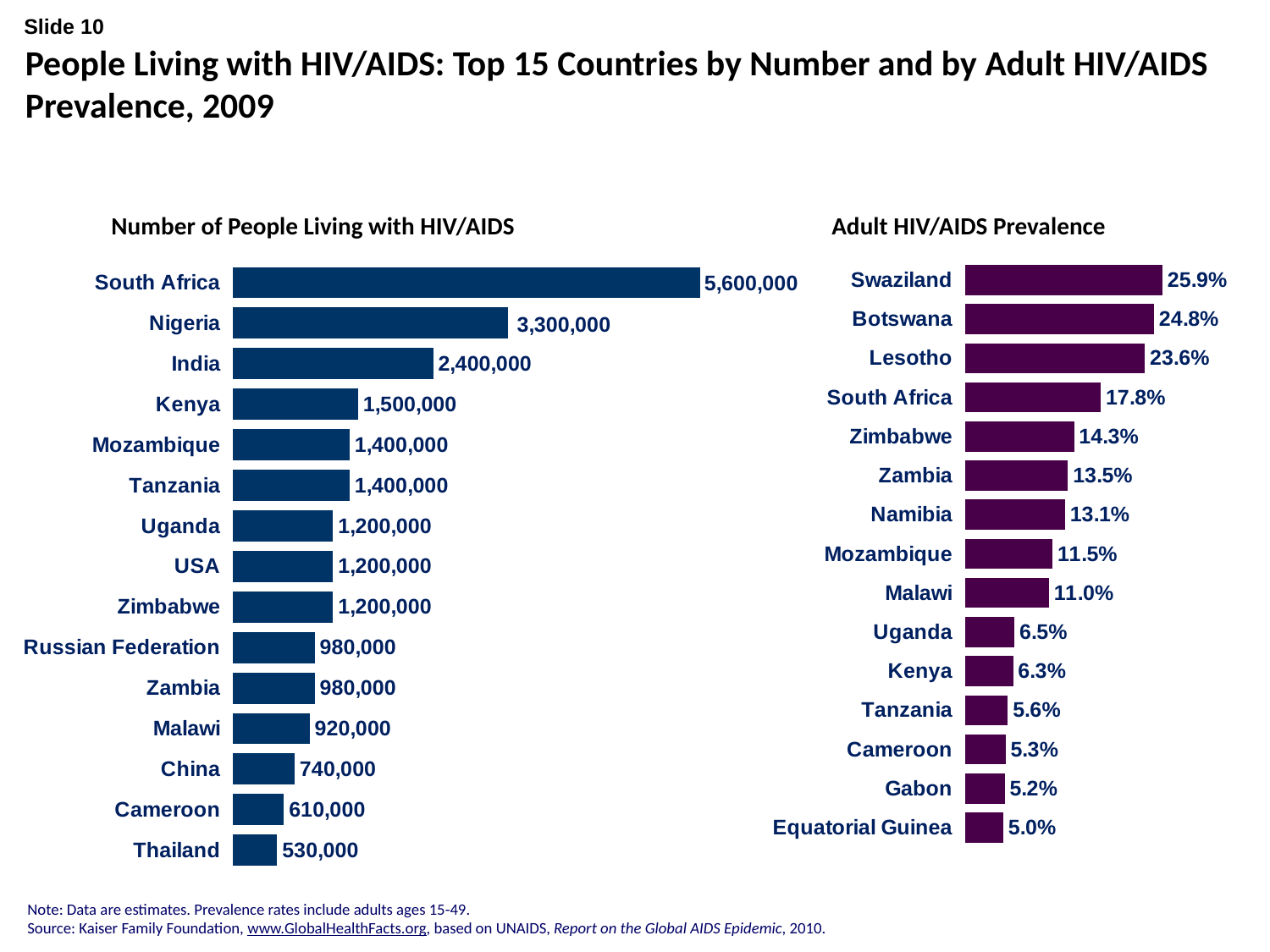
In the 'Adult HIV/AIDS Prevalence' chart, which is larger, the value for Namibia or the value for Malawi? Namibia In the 'Number of People Living with HIV/AIDS' chart, which country has the highest value? South Africa In the 'Number of People Living with HIV/AIDS' chart, what is the value for China? 740,000 In the 'Number of People Living with HIV/AIDS' chart, what is the difference between South Africa and India? 3,200,000 In the 'Adult HIV/AIDS Prevalence' chart, what is the value for Zimbabwe? 14.3% In the 'Adult HIV/AIDS Prevalence' chart, what is the difference between Swaziland and Botswana? 1.1% What kind of chart is the 'Adult HIV/AIDS Prevalence' chart? Bar chart In the 'Number of People Living with HIV/AIDS' chart, what is the value for Nigeria? 3,300,000 In the 'Adult HIV/AIDS Prevalence' chart, which country has the highest prevalence? Swaziland In the 'Number of People Living with HIV/AIDS' chart, which country has the lowest value? Thailand In the 'Adult HIV/AIDS Prevalence' chart, which country has the lowest prevalence? Equatorial Guinea In the 'Number of People Living with HIV/AIDS' chart, how many countries are shown? 15